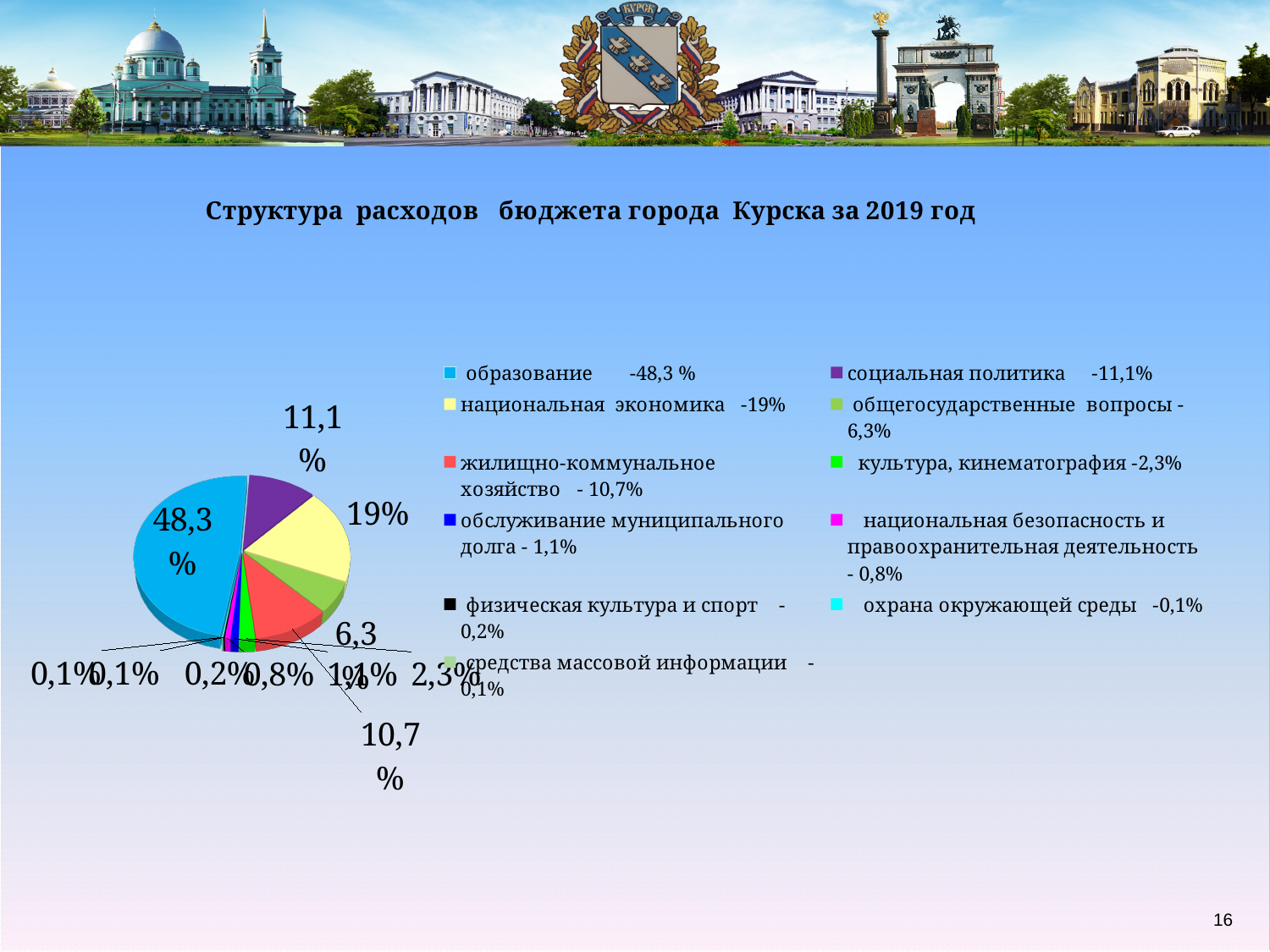
How many categories does the legend list? 11 What share of the budget expenditure goes to социальная политика? 11,1% What share of the budget expenditure goes to жилищно-коммунальное хозяйство? 10,7% What is the difference in percentage points between образование and национальная экономика? 29,3 What is the difference in percentage points between общегосударственные вопросы and культура, кинематография? 4 What type of chart is shown on the slide? pie chart What share of the budget expenditure goes to культура, кинематография? 2,3% What is the title of the slide's chart? Структура расходов бюджета города Курска за 2019 год Which has a larger share: социальная политика or жилищно-коммунальное хозяйство? социальная политика What share of the budget expenditure goes to образование? 48,3% Which category has the largest share of the budget expenditure? образование What share of the budget expenditure goes to национальная экономика? 19%